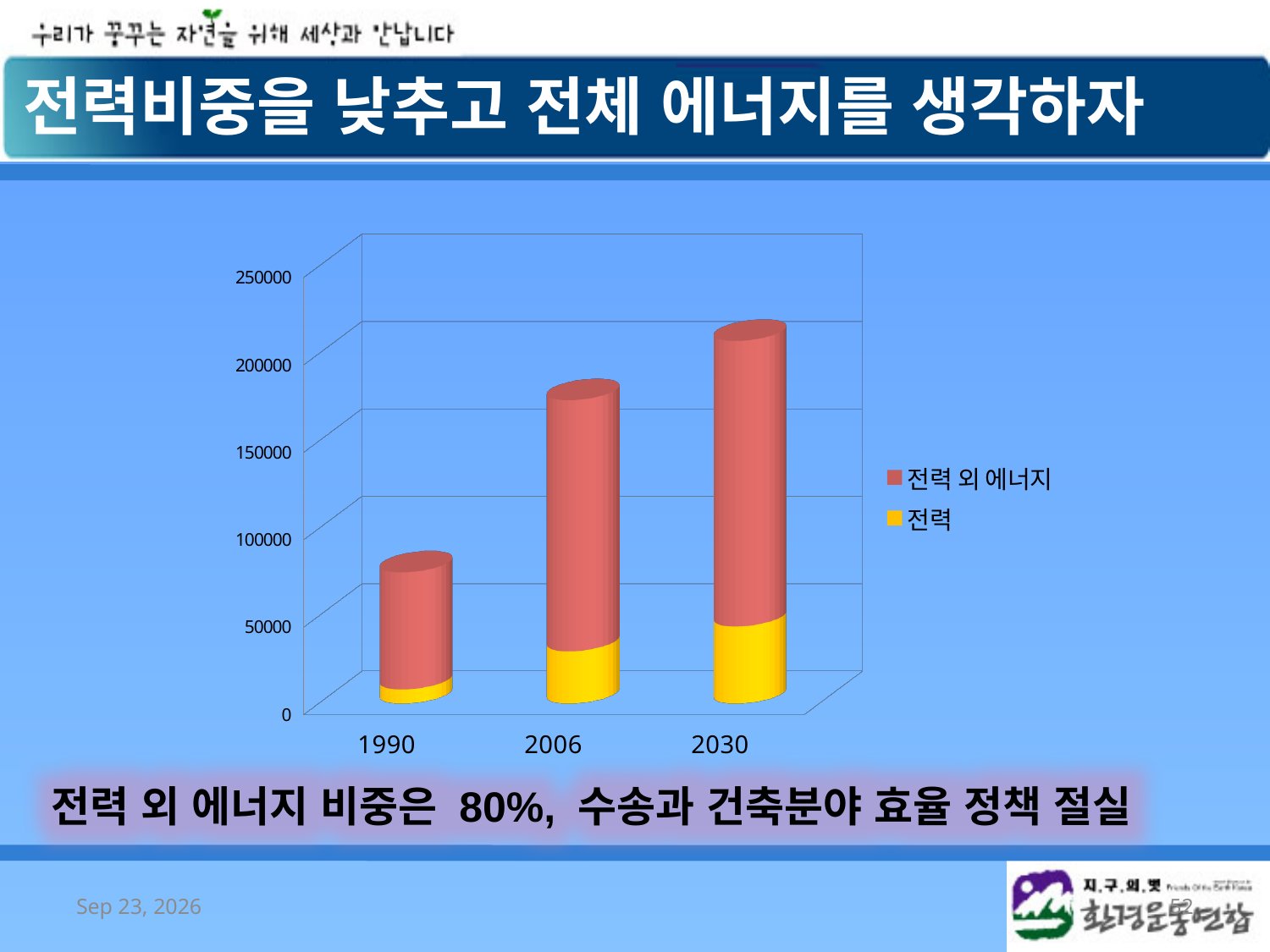
Is the 전력 value for 2006 greater or less than 50000? less Which year has the shortest stacked bar in the chart? 1990 Which series are listed in the chart's legend? 전력 외 에너지, 전력 What kind of chart is shown on the slide? Stacked bar chart Which is larger in 2030, the 전력 외 에너지 segment or the 전력 segment? 전력 외 에너지 Is the total value for 2006 greater or less than 150000? greater Is the total value for 2030 greater or less than 250000? less How many series does the chart's legend list? 2 Do the total bar heights rise or fall from 1990 to 2030? Rise How many categories (years) are shown on the x axis of the chart? 3 Which year has the tallest stacked bar in the chart? 2030